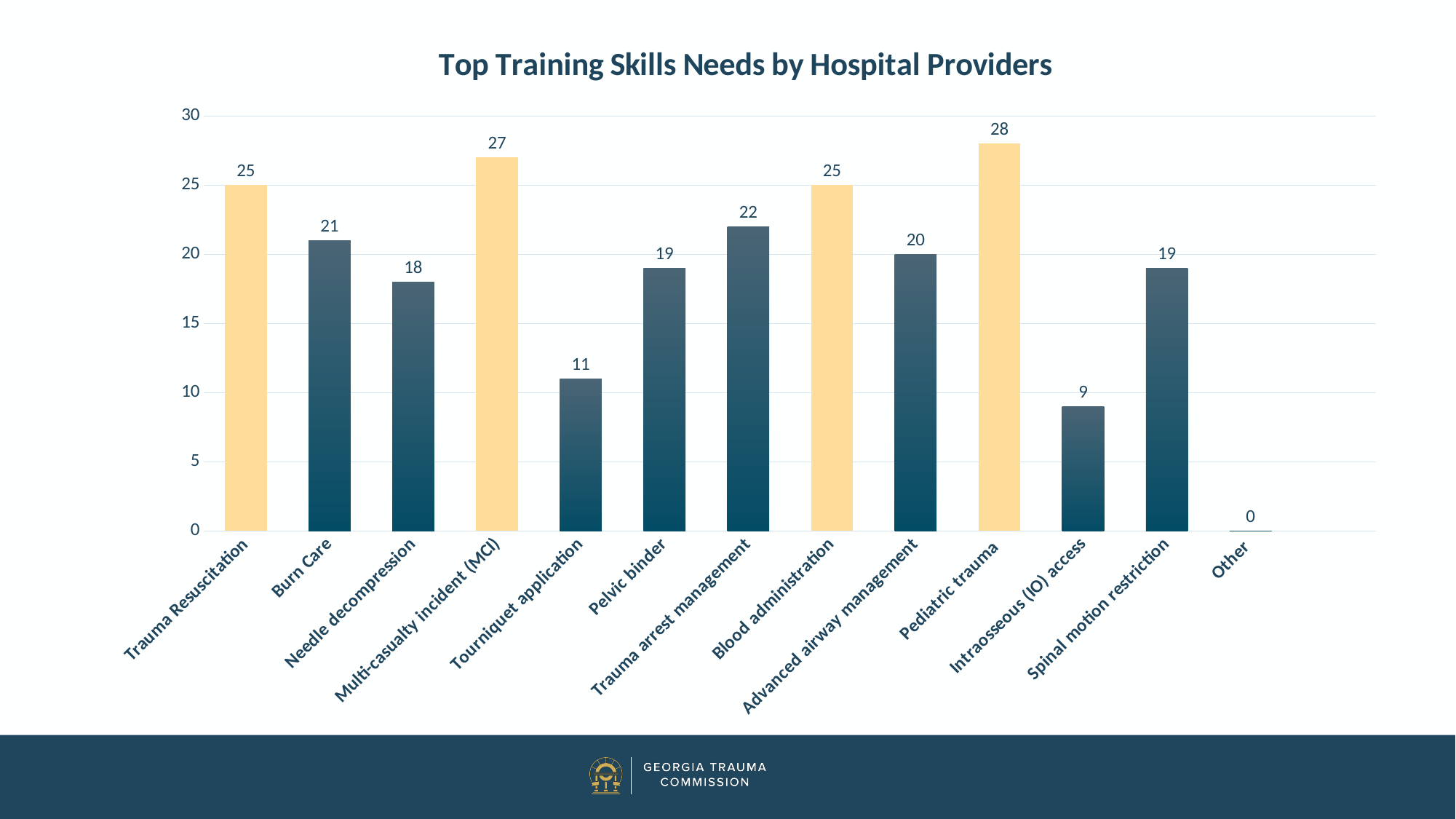
Which category has the lowest value? Other How many bars are coloured yellow? 4 What is the title of the chart? Top Training Skills Needs by Hospital Providers What is the value for Tourniquet application? 11 What is the value for Trauma arrest management? 22 What is the value for Pediatric trauma? 28 What is the difference between the values for Multi-casualty incident (MCI) and Burn Care? 6 What kind of chart is this? Bar chart How many categories are shown on the x axis? 13 Which is larger, the value for Needle decompression or the value for Advanced airway management? Advanced airway management Is the value for Intraosseous (IO) access greater or less than 10? less Which category has the highest value? Pediatric trauma